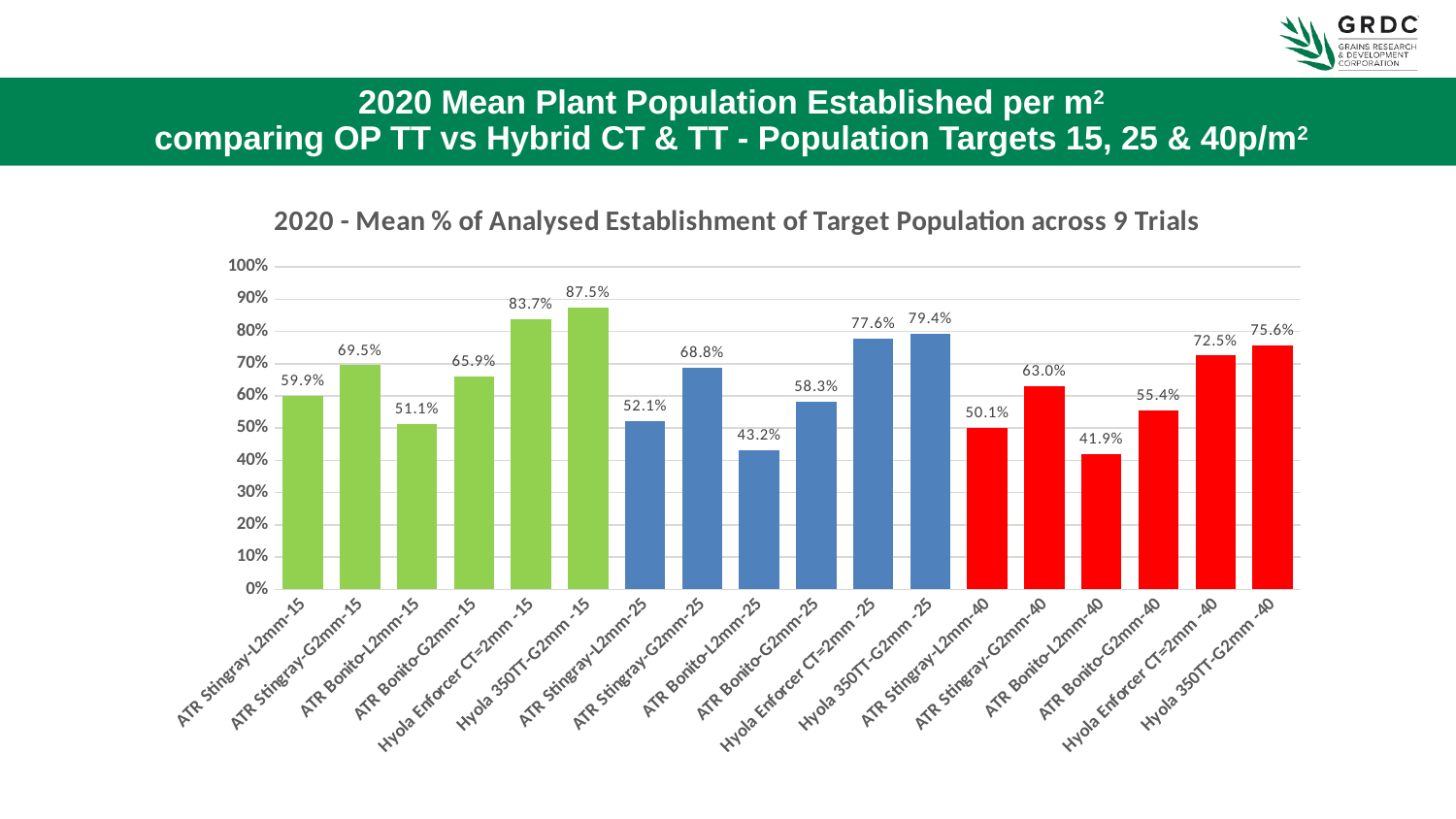
Which is larger, ATR Stingray-L2mm-15 or ATR Stingray-L2mm-25? ATR Stingray-L2mm-15 What is the difference between Hyola 350TT-G2mm -15 and Hyola Enforcer CT=2mm -15? 3.8% Is the value for ATR Bonito-G2mm-25 greater or less than 50%? greater What is the difference between ATR Stingray-G2mm-40 and ATR Bonito-G2mm-40? 7.6% What is the value for Hyola Enforcer CT=2mm -40? 72.5% What is the value for ATR Bonito-L2mm-25? 43.2% Which category has the highest value? Hyola 350TT-G2mm -15 What is the value for ATR Stingray-G2mm-15? 69.5% What is the title of the chart? 2020 - Mean % of Analysed Establishment of Target Population across 9 Trials What kind of chart is shown on the slide? bar chart Which category has the lowest value? ATR Bonito-L2mm-40 How many bars are plotted in the chart? 18